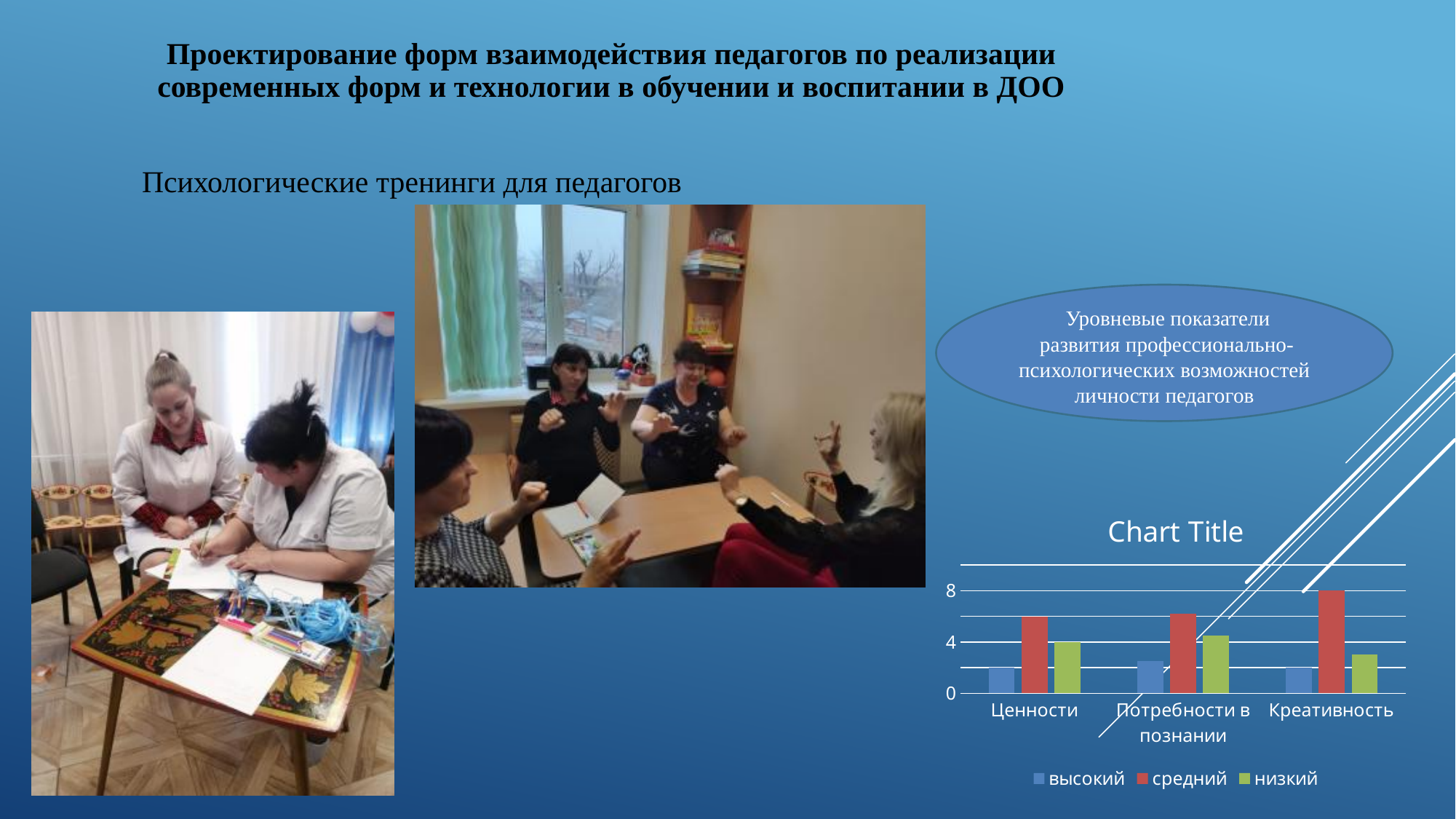
Within the Креативность category, which series has the lowest value? высокий Which series is shown in red in the chart? средний Within the Ценности category, which series has the highest value? средний Is the value for средний in Креативность greater or less than 4? greater How many series does the chart legend list? 3 In the Потребности в познании category, which is larger: the средний value or the высокий value? средний Which category has the highest value for the средний series? Креативность What kind of chart is shown on the slide? bar chart Is the value for высокий in Ценности greater or less than 4? less Is the value for низкий in Креативность greater or less than 4? less How many categories are shown on the x axis of the chart? 3 What is the title shown above the chart? Chart Title